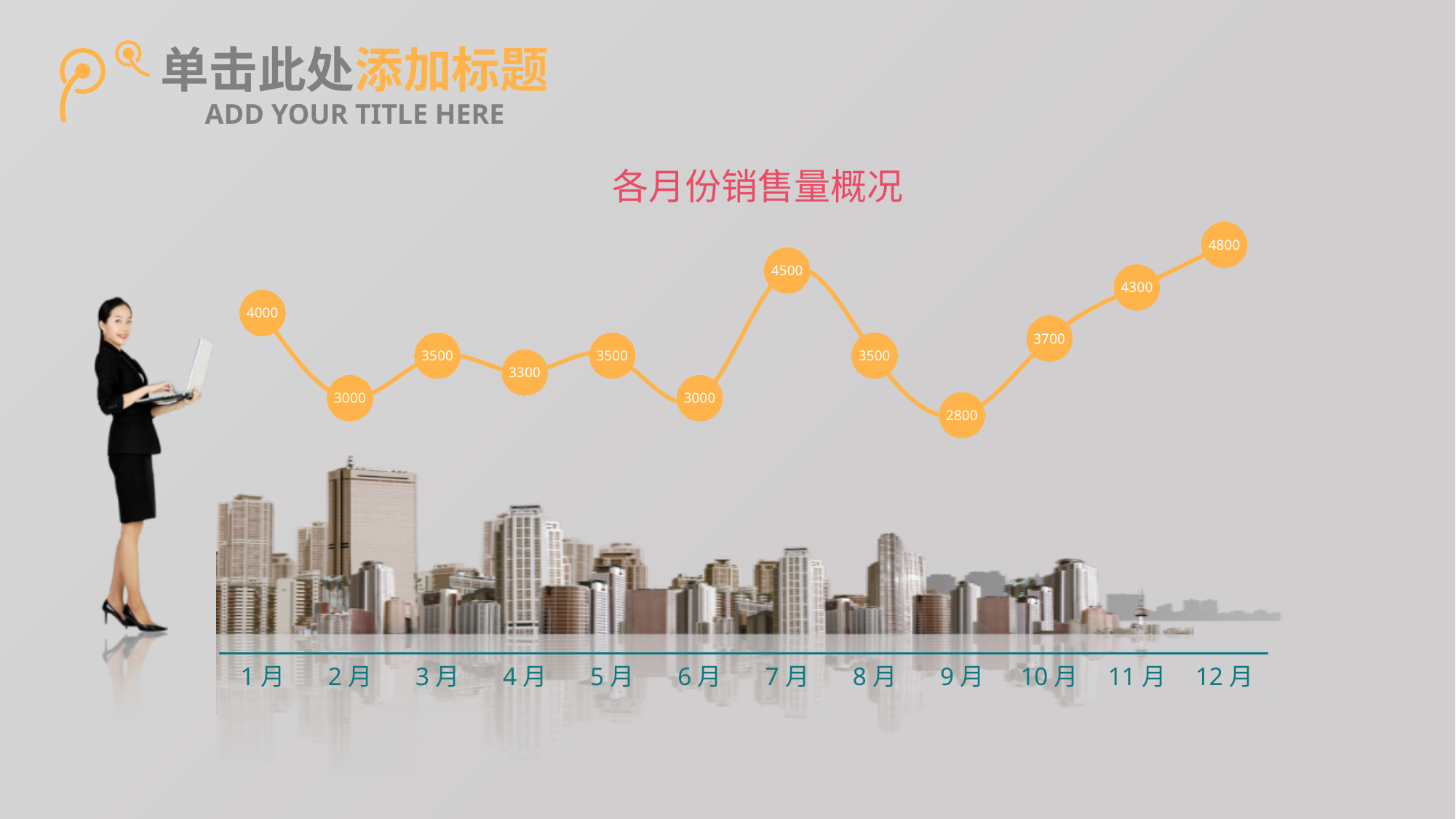
What is the difference between the values for 7月 and 8月? 1000 What is the value for 10月? 3700 How many months are plotted on the chart? 12 Which is larger, the value for 4月 or the value for 5月? 5月 Which month has the lowest value? 9月 What is the value for 7月? 4500 What kind of chart is shown? line chart What is the difference between the values for 12月 and 11月? 500 What is the value for 1月? 4000 Which month has the highest value? 12月 What is the title of the chart? 各月份销售量概况 What is the value for 9月? 2800